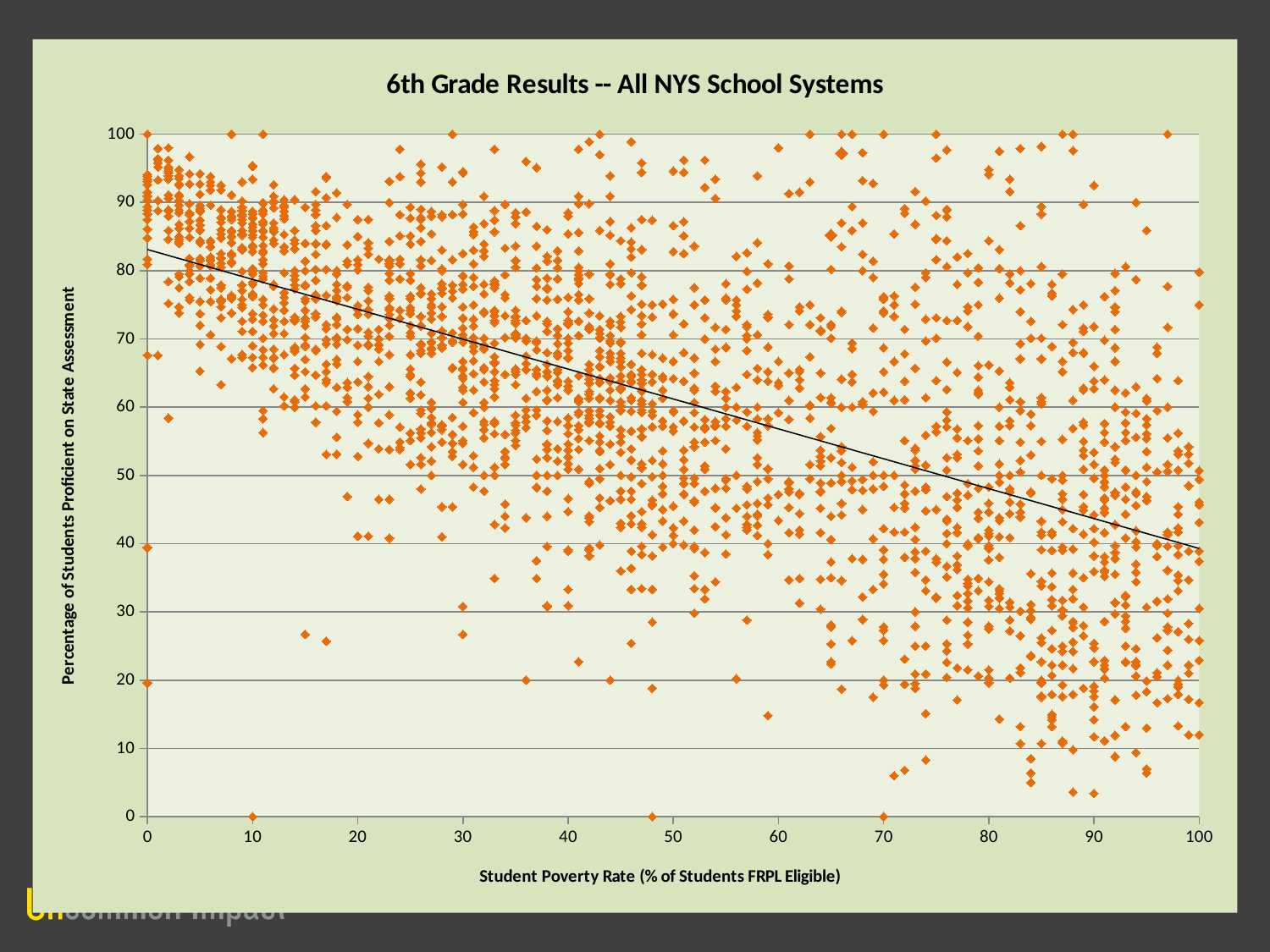
Is the trend line's value at a student poverty rate of 0 greater or less than 70? greater What is the title of the chart? 6th Grade Results -- All NYS School Systems Is the trend line's value at a student poverty rate of 100 greater or less than 50? less As the student poverty rate increases along the x axis, does the trend line rise or fall? fall What is the label of the x axis? Student Poverty Rate (% of Students FRPL Eligible) What is the highest value shown on the y axis? 100 What kind of chart is shown on the slide? scatter chart What is the highest value shown on the x axis? 100